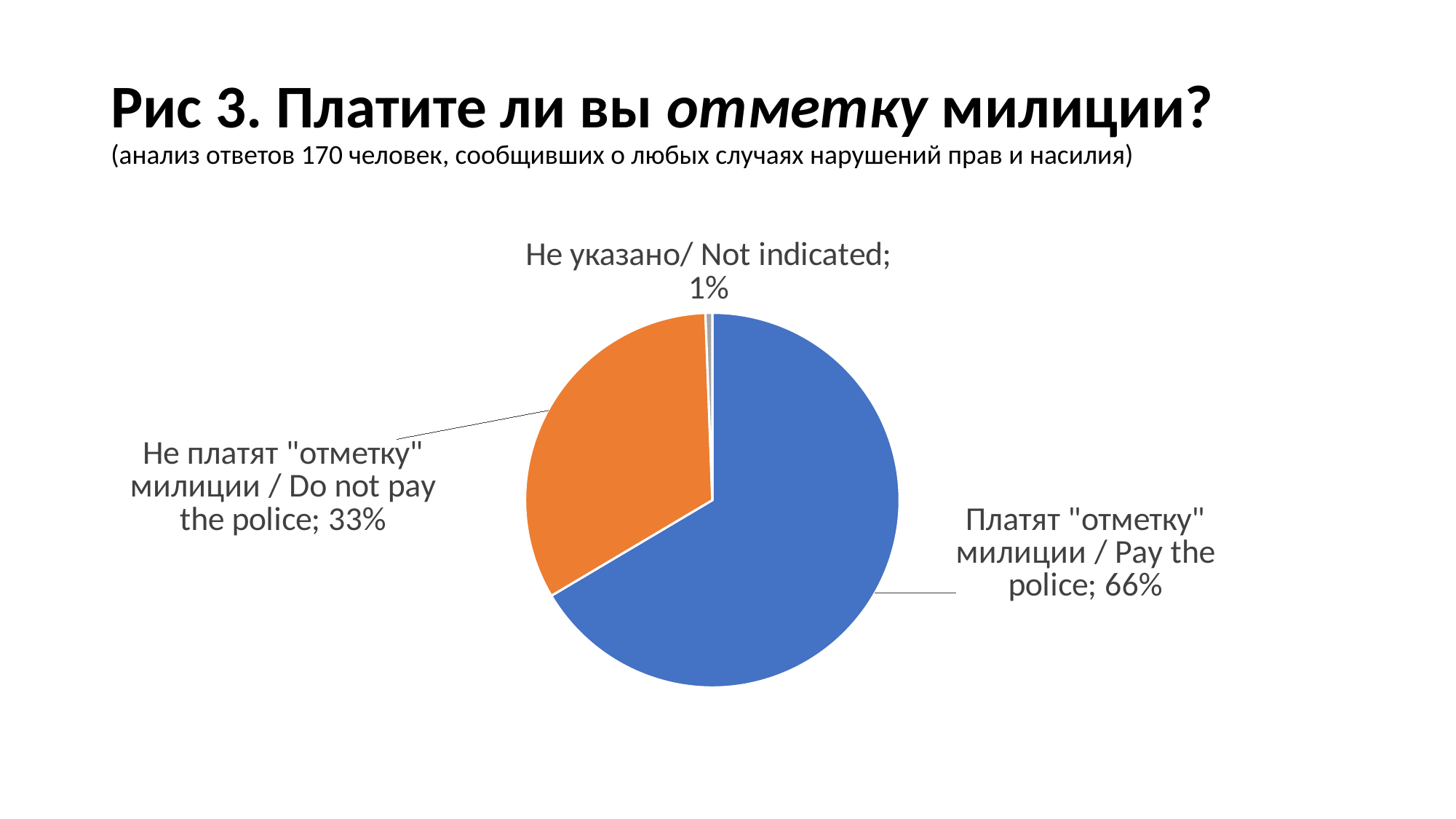
Which slice of the pie is the largest? Платят "отметку" милиции / Pay the police What share of responses is labelled "Не указано/ Not indicated"? 1% Which slice of the pie is the smallest? Не указано/ Not indicated What share of respondents do not pay the police ("Не платят "отметку" милиции / Do not pay the police")? 33% What colour is the "Pay the police" slice? blue What is the difference in percentage points between the "Pay the police" slice and the "Do not pay the police" slice? 33 Which is larger: the "Pay the police" slice or the "Do not pay the police" slice? Pay the police What share of respondents pay the police ("Платят "отметку" милиции / Pay the police")? 66% What kind of chart is shown on the slide? pie chart How many slices does the pie chart have? 3 How many people's answers were analysed according to the slide subtitle? 170